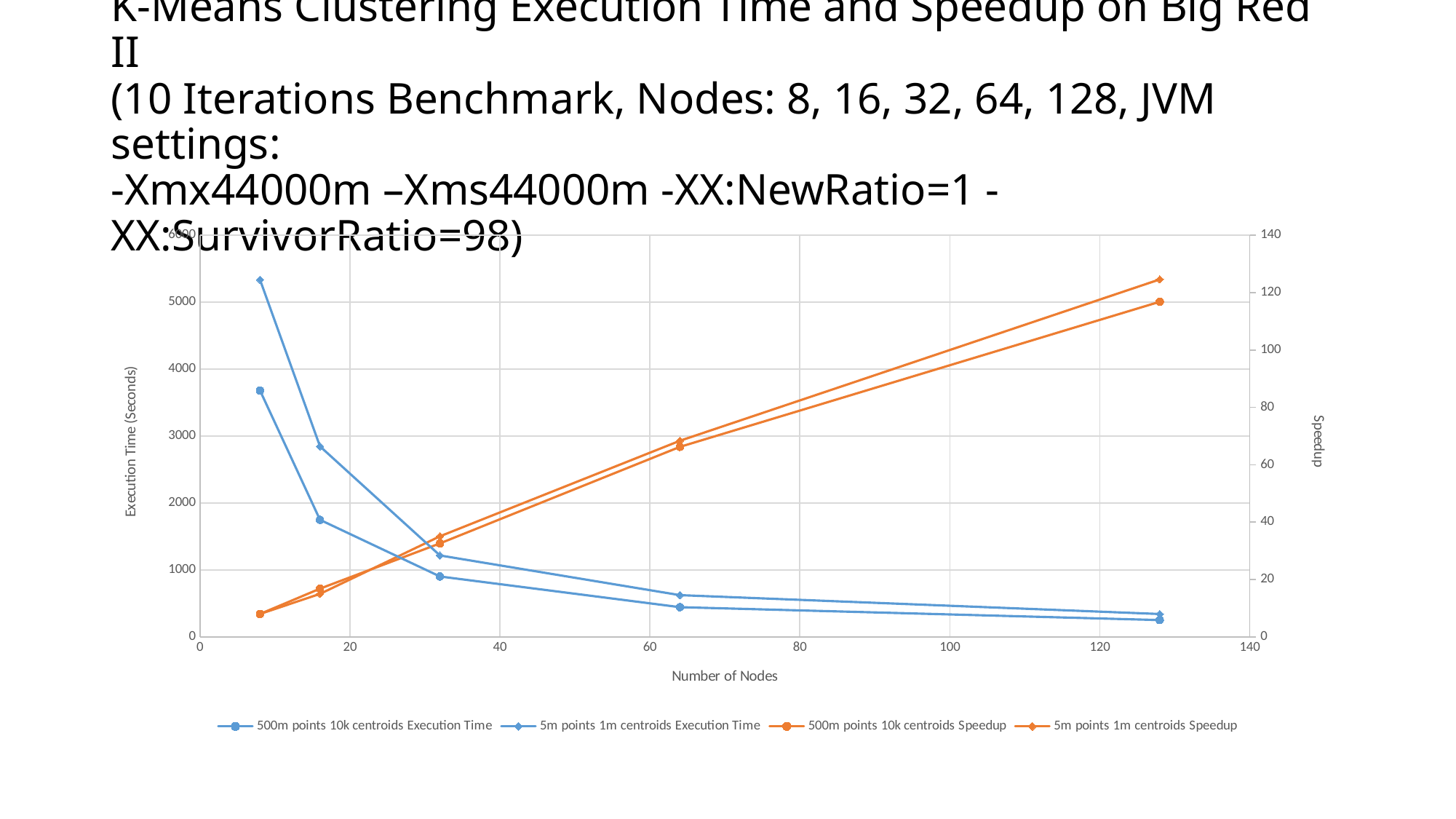
How many data points are plotted for the 500m points 10k centroids Execution Time series? 5 What kind of chart is shown on the slide? line chart What is the title of the left vertical axis? Execution Time (Seconds) What is the title of the horizontal axis? Number of Nodes At 8 nodes, which series has the higher execution time: 500m points 10k centroids or 5m points 1m centroids? 5m points 1m centroids Is the speedup for 5m points 1m centroids at 128 nodes greater or less than 120? greater Is the execution time for 5m points 1m centroids at 8 nodes greater or less than 5000 seconds? greater How many series does the legend list? 4 Do the speedup series rise or fall as the number of nodes increases? rise Is the execution time for 500m points 10k centroids at 8 nodes greater or less than 3000 seconds? greater Do the execution time series rise or fall as the number of nodes increases? fall